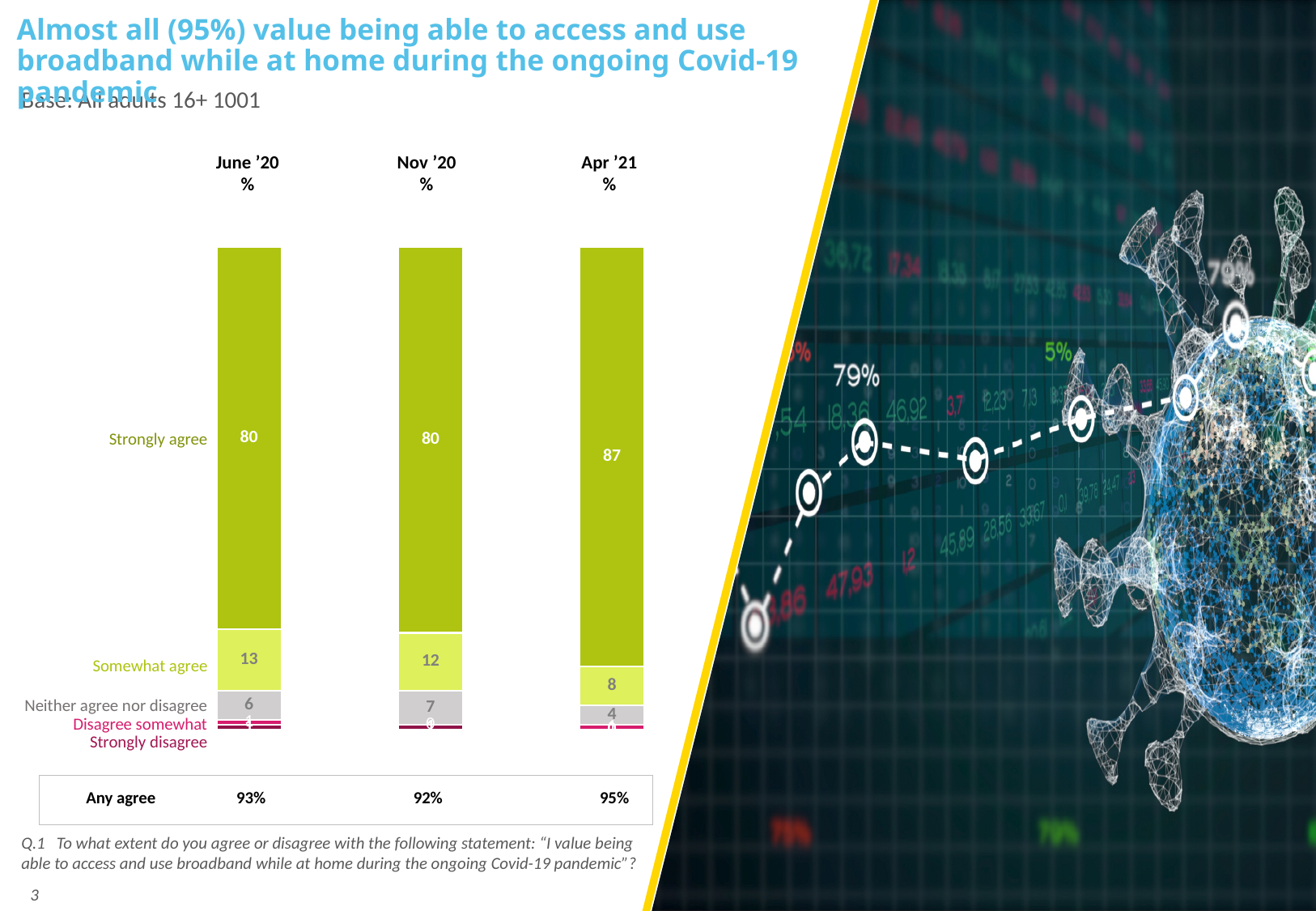
What is the Strongly agree value for Apr '21? 87 What is the Somewhat agree value for June '20? 13 What is the difference between the Strongly agree values for Apr '21 and Nov '20? 7 Which wave has the lowest Somewhat agree value? Apr '21 Is the Somewhat agree value larger for June '20 or Nov '20? June '20 Does the Strongly agree value rise or fall from Nov '20 to Apr '21? rise How many response categories are listed beside the bars? 5 Which wave has the highest Strongly agree value? Apr '21 What is the Neither agree nor disagree value for Nov '20? 7 What kind of chart is shown on the slide? stacked bar chart What is the Any agree figure for Apr '21? 95% How many survey waves (bars) are shown in the chart? 3